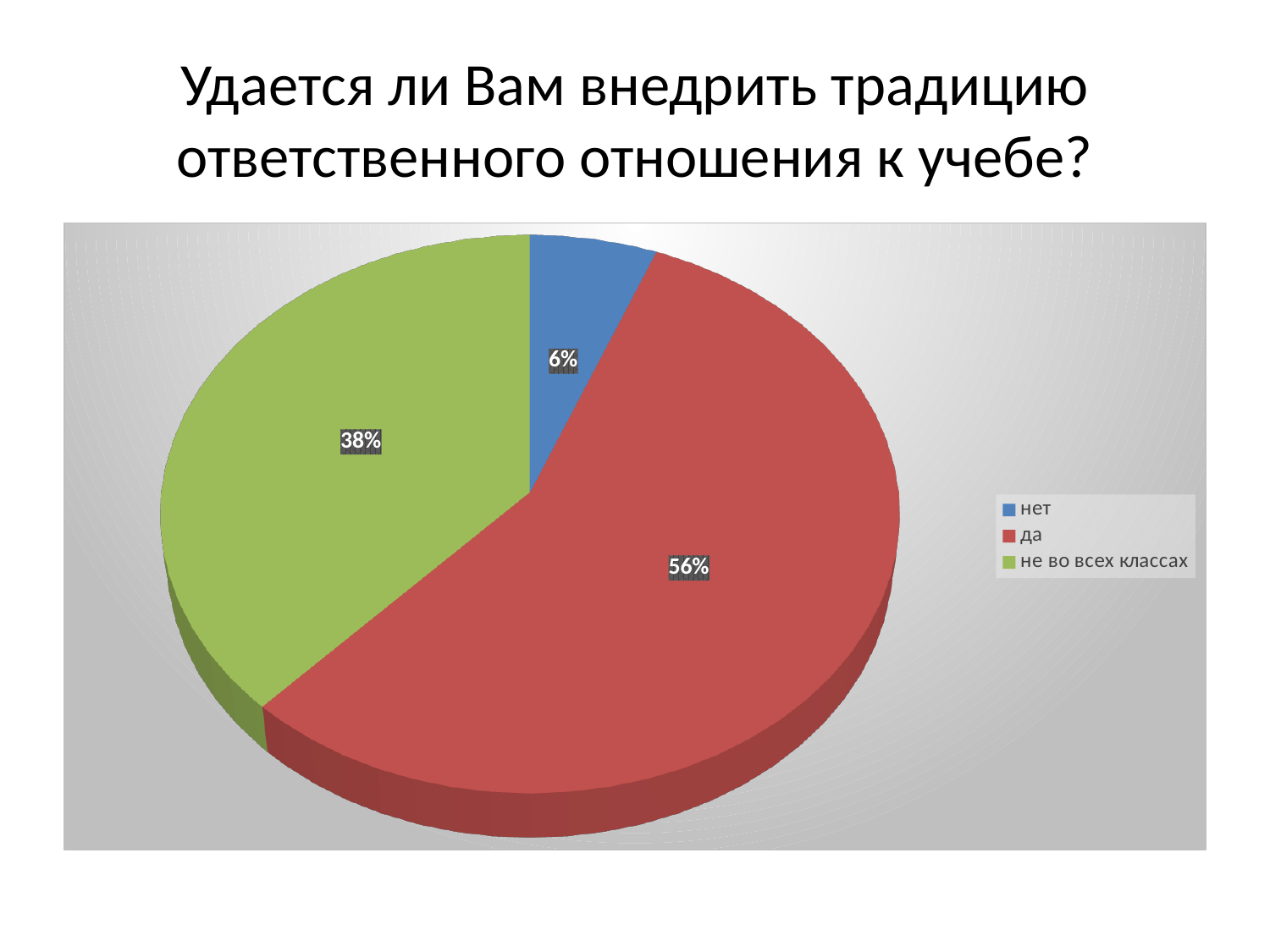
What is the difference in percentage points between the "да" and "не во всех классах" slices? 18 How many slices does the pie chart have? 3 Which slice is larger, "нет" or "не во всех классах"? не во всех классах What share of the pie does the "не во всех классах" slice represent? 38% What share of the pie does the "нет" slice represent? 6% Which category has the largest slice of the pie? да How many entries does the legend list? 3 What kind of chart is shown on the slide? pie chart What colour is the "нет" slice in the pie chart? blue Which category has the smallest slice of the pie? нет What share of the pie does the "да" slice represent? 56% What colour is the "да" slice in the pie chart? red